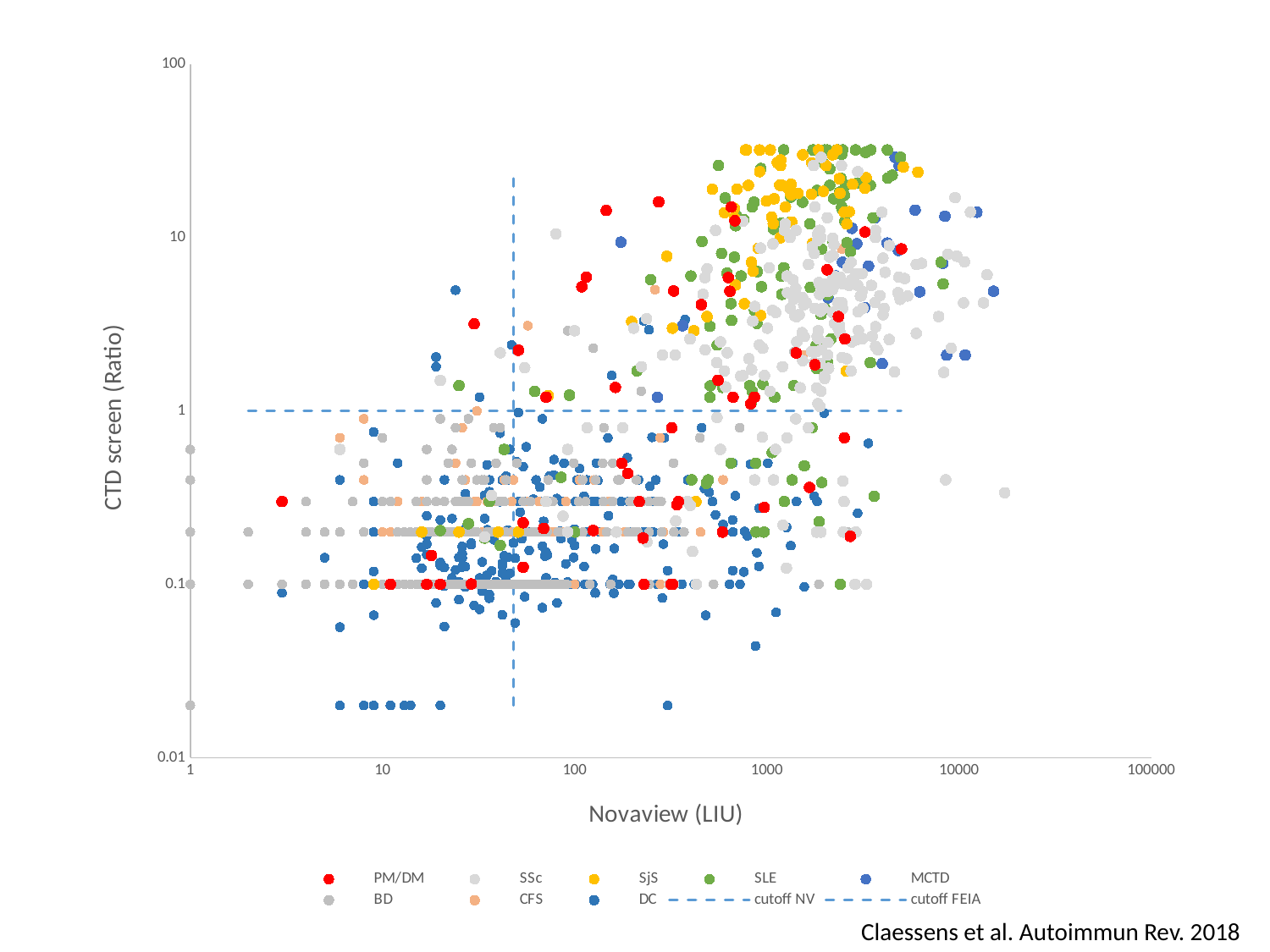
At what value on the CTD screen (Ratio) axis is the horizontal dashed cutoff line drawn? 1 How many disease groups (excluding the two cutoff lines) are listed in the legend? 8 How many entries does the chart legend list? 10 What is the highest tick value shown on the Novaview (LIU) axis? 100000 What is the label of the x axis? Novaview (LIU) Are the SjS points mostly above or below the CTD screen cutoff value of 1? above What is the label of the y axis? CTD screen (Ratio) Are the DC points mostly above or below the CTD screen cutoff value of 1? below What is the lowest tick value shown on the CTD screen (Ratio) axis? 0.01 What kind of chart is shown on the slide? scatter plot